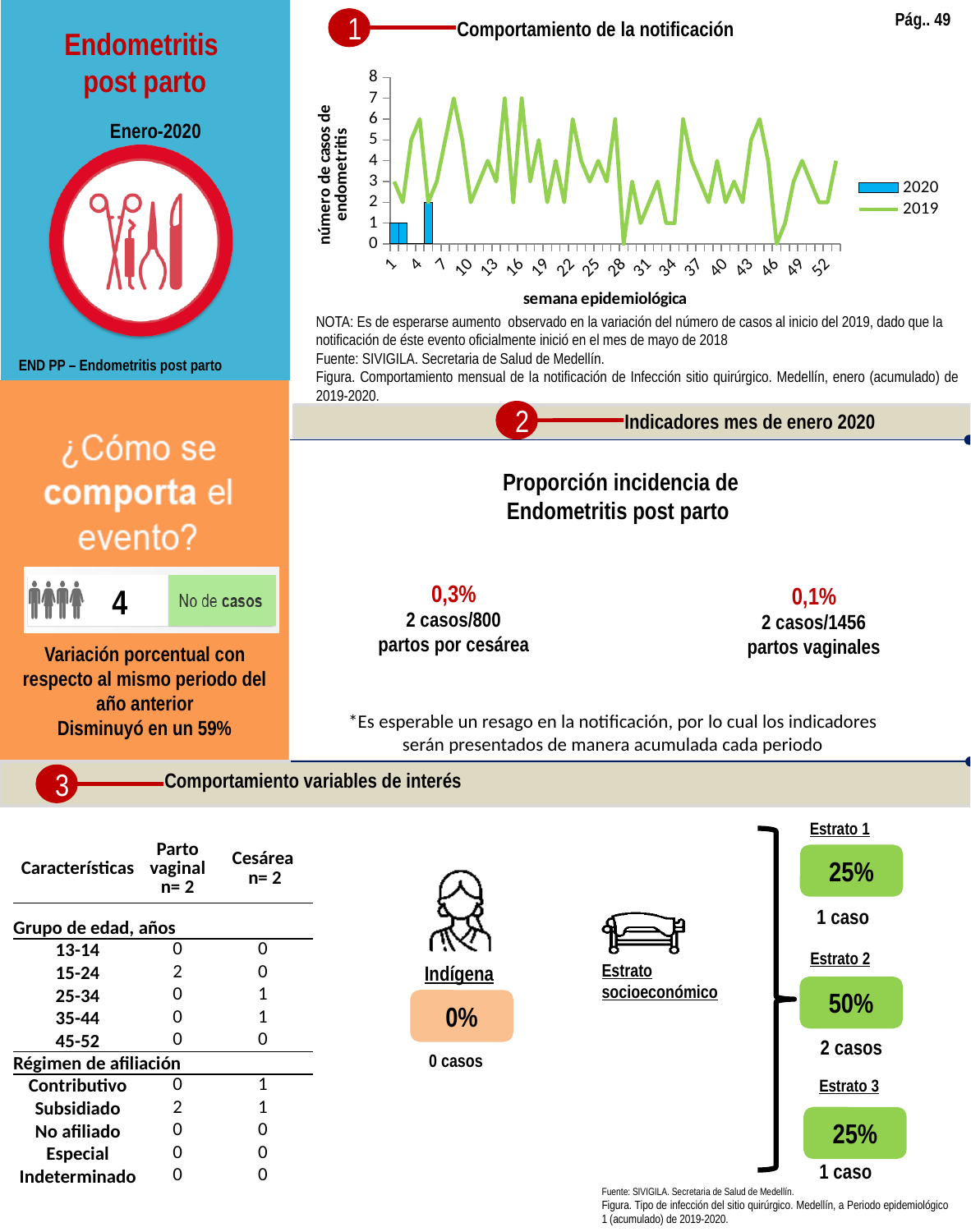
What is the y-axis title of the 'Comportamiento de la notificación' chart? número de casos de endometritis What kind of chart is shown under 'Comportamiento de la notificación'? A combined bar and line chart In the 'Comportamiento de la notificación' chart, is the tallest 2020 bar greater or less than 4? less How many 2020 bars are plotted in the 'Comportamiento de la notificación' chart? 3 In the 'Comportamiento de la notificación' chart, which series is drawn as bars? 2020 In the 'Comportamiento de la notificación' chart, what is the lowest value reached by the 2019 line? 0 In the 'Comportamiento de la notificación' chart, what is the 2019 value at epidemiological week 28? 0 In the 'Comportamiento de la notificación' chart, what is the highest value reached by the 2019 line? 7 How many series does the legend of the 'Comportamiento de la notificación' chart list? 2 What is the maximum value shown on the y-axis of the 'Comportamiento de la notificación' chart? 8 In the 'Comportamiento de la notificación' chart, what is the 2020 value at week 1? 1 In the 'Comportamiento de la notificación' chart, which is larger at week 1: the 2019 value or the 2020 value? 2019